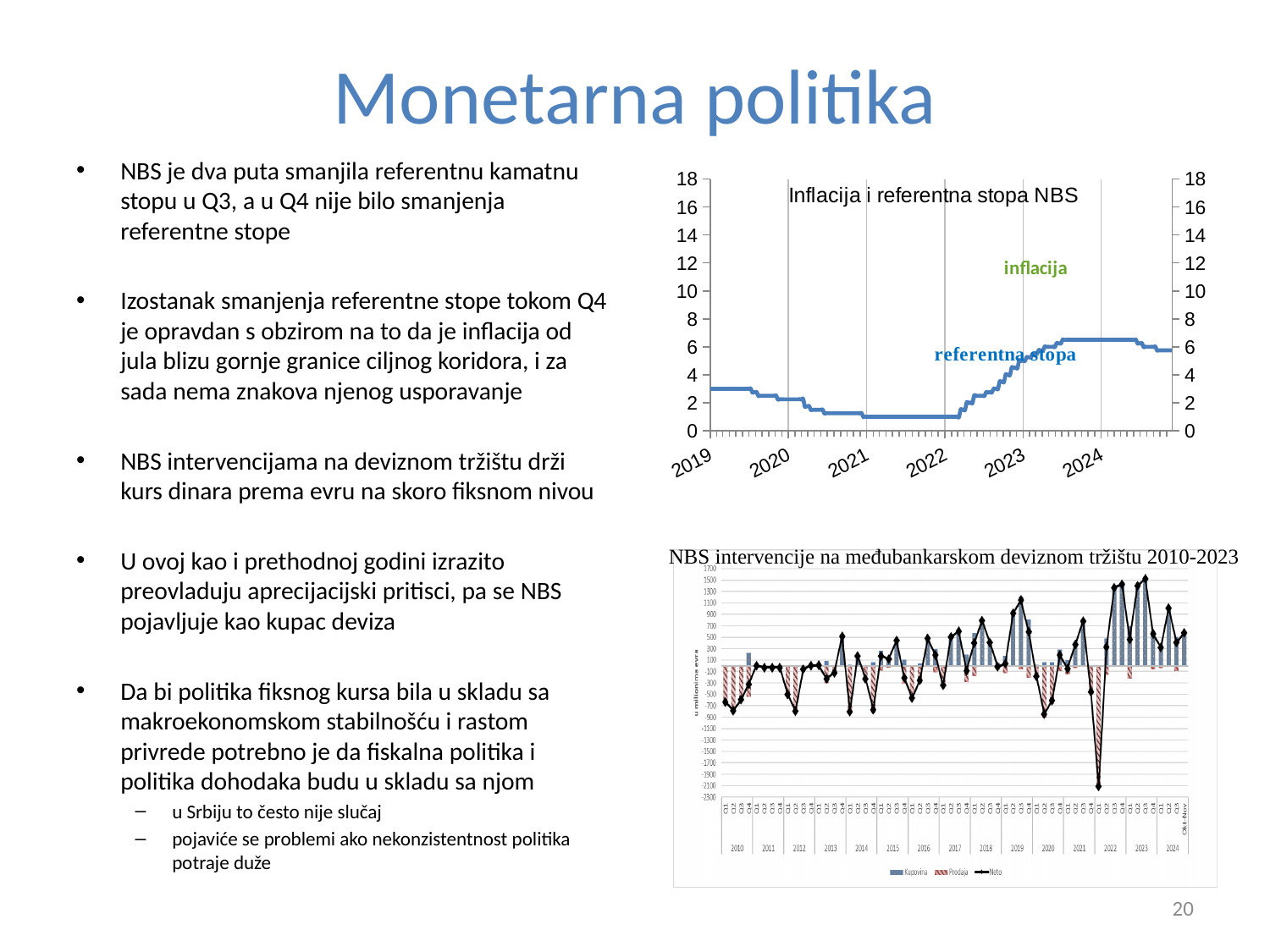
On the bottom chart 'NBS intervencije na međubankarskom deviznom tržištu 2010-2023', is the lowest Neto value (in 2022) greater or less than -1500? less What kind of chart is the top chart titled 'Inflacija i referentna stopa NBS'? line chart On the bottom chart 'NBS intervencije na međubankarskom deviznom tržištu 2010-2023', in which year does the Neto line reach its highest point? 2023 On the bottom chart 'NBS intervencije na međubankarskom deviznom tržištu 2010-2023', in which year does the Neto line reach its lowest point? 2022 On the top chart 'Inflacija i referentna stopa NBS', is the referentna stopa in 2024 greater or less than 4? greater How many series does the legend of the bottom chart 'NBS intervencije na međubankarskom deviznom tržištu 2010-2023' list? 3 On the top chart 'Inflacija i referentna stopa NBS', does the referentna stopa rise or fall between 2019 and 2021? fall On the top chart 'Inflacija i referentna stopa NBS', does the referentna stopa rise or fall between 2022 and 2023? rise On the top chart 'Inflacija i referentna stopa NBS', what is the highest value shown on the vertical axis? 18 On the top chart 'Inflacija i referentna stopa NBS', what is the first year labelled on the horizontal axis? 2019 On the bottom chart 'NBS intervencije na međubankarskom deviznom tržištu 2010-2023', is the highest Neto value (in 2023) greater or less than 1300? greater